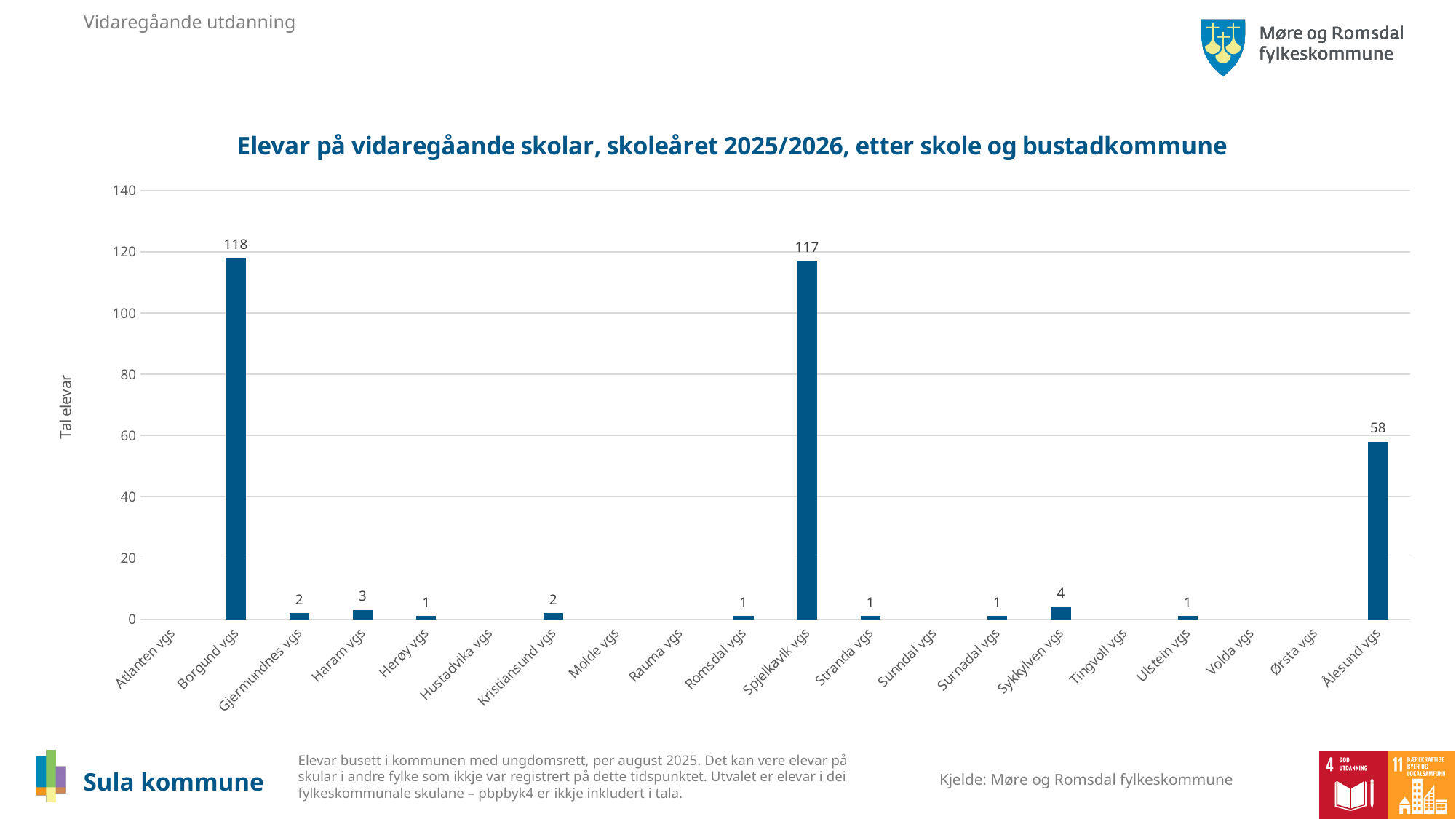
What is the label of the y axis? Tal elevar What is the value for Sykkylven vgs? 4 Is the value for Ålesund vgs greater or less than 40? greater What kind of chart is shown on the slide? bar chart What is the value for Ålesund vgs? 58 How many schools are listed on the x axis? 20 What is the difference between the values for Borgund vgs and Ålesund vgs? 60 What is the value for Spjelkavik vgs? 117 Which school has the highest number of students? Borgund vgs Which is larger, the value for Borgund vgs or the value for Spjelkavik vgs? Borgund vgs What is the value for Haram vgs? 3 How many students from Sula kommune attend Borgund vgs? 118